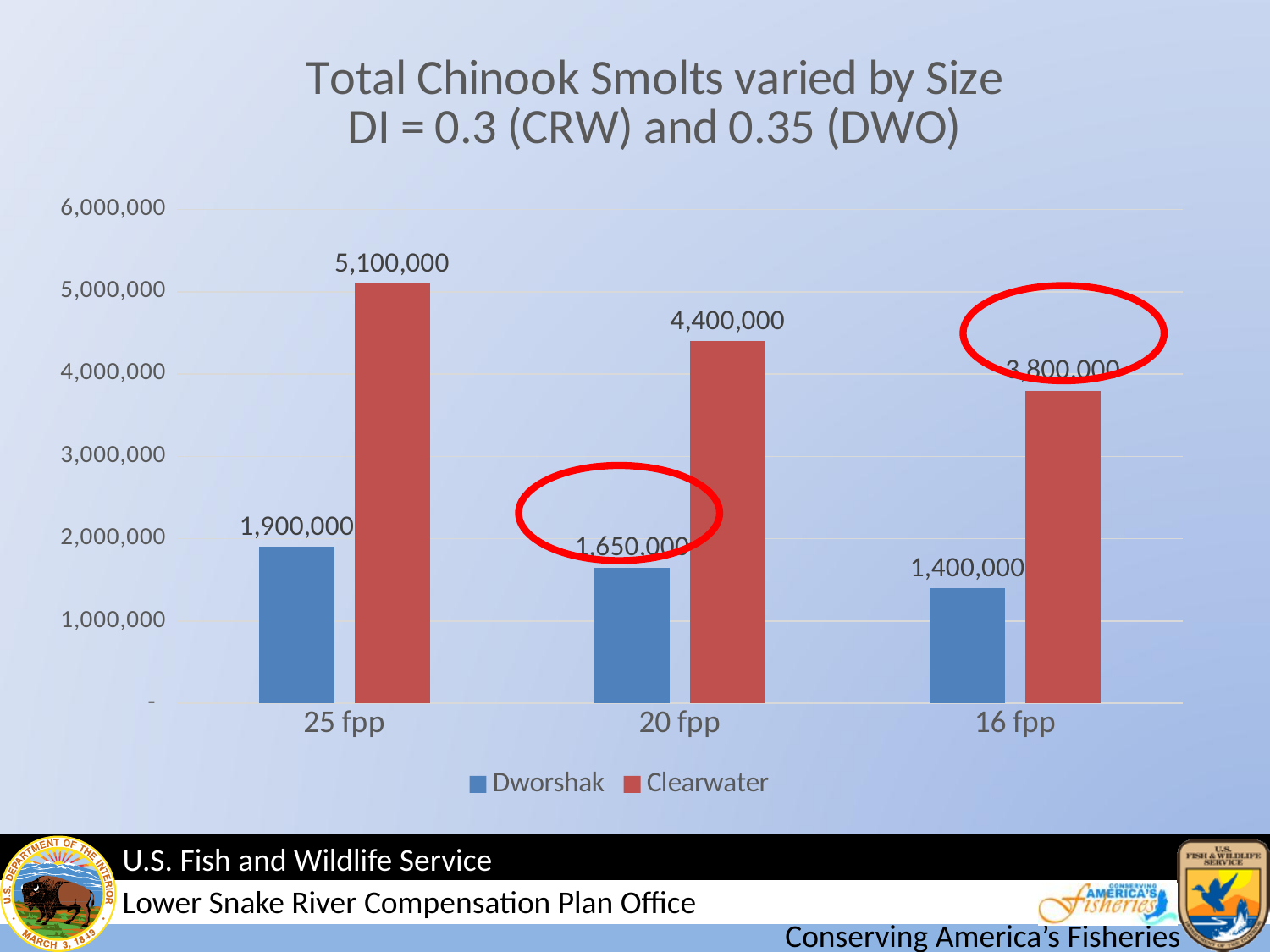
Do the Dworshak values rise or fall from 25 fpp to 16 fpp? fall What is the value for Dworshak at 25 fpp? 1,900,000 Which category has the lowest Dworshak value? 16 fpp What is the value for Clearwater at 25 fpp? 5,100,000 What is the value for Clearwater at 20 fpp? 4,400,000 How many series does the legend list? 2 What is the difference between the Clearwater and Dworshak values at 25 fpp? 3,200,000 How many categories are shown on the x axis? 3 Which category has the highest Clearwater value? 25 fpp Is the Clearwater value at 16 fpp greater or less than 3,000,000? greater What is the value for Dworshak at 16 fpp? 1,400,000 Which is larger at 20 fpp, the Dworshak value or the Clearwater value? Clearwater